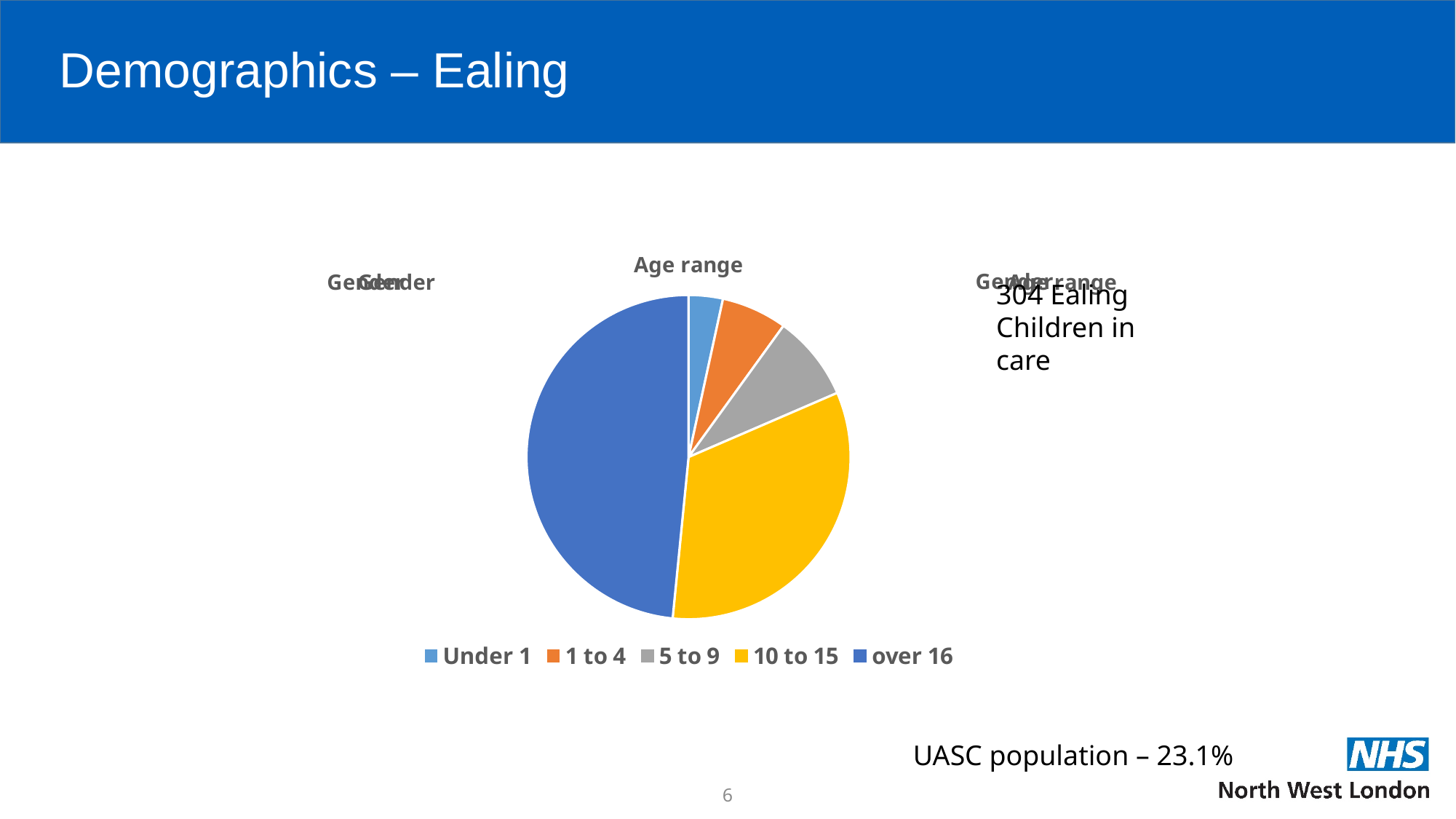
How many entries does the legend of the "Age range" chart list? 5 What is the title of the pie chart on the slide? Age range In the "Age range" pie chart, which slice is larger: "Under 1" or "10 to 15"? 10 to 15 Which age range has the smallest slice in the "Age range" pie chart? Under 1 In the "Age range" pie chart, which slice is larger: "over 16" or "10 to 15"? over 16 How many slices does the "Age range" pie chart have? 5 Which age range has the largest slice in the "Age range" pie chart? over 16 What colour is the "10 to 15" slice in the "Age range" pie chart? yellow In the "Age range" pie chart, which slice is larger: "1 to 4" or "over 16"? over 16 What kind of chart is the "Age range" chart? pie chart